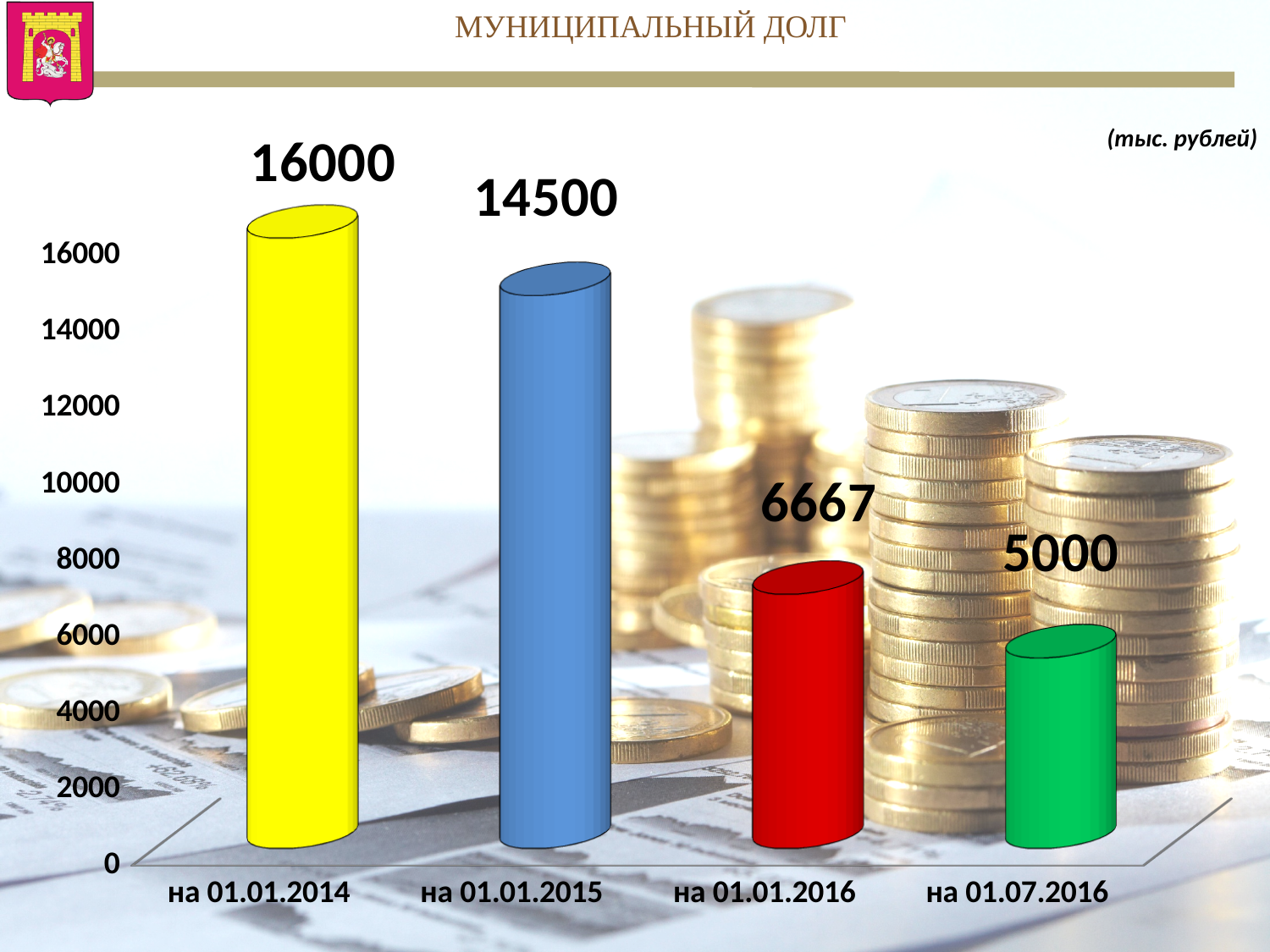
Which is larger, the value for на 01.01.2015 or the value for на 01.01.2016? на 01.01.2015 What is the municipal debt value for на 01.01.2014? 16000 What is the municipal debt value for на 01.01.2015? 14500 What kind of chart is shown on the slide? bar chart How many dates are shown on the chart? 4 What is the municipal debt value for на 01.07.2016? 5000 What is the difference between the values for на 01.01.2016 and на 01.07.2016? 1667 What is the municipal debt value for на 01.01.2016? 6667 Do the values rise or fall from на 01.01.2014 to на 01.07.2016? fall What is the difference between the values for на 01.01.2014 and на 01.01.2015? 1500 Which date has the highest municipal debt? на 01.01.2014 Which date has the lowest municipal debt? на 01.07.2016